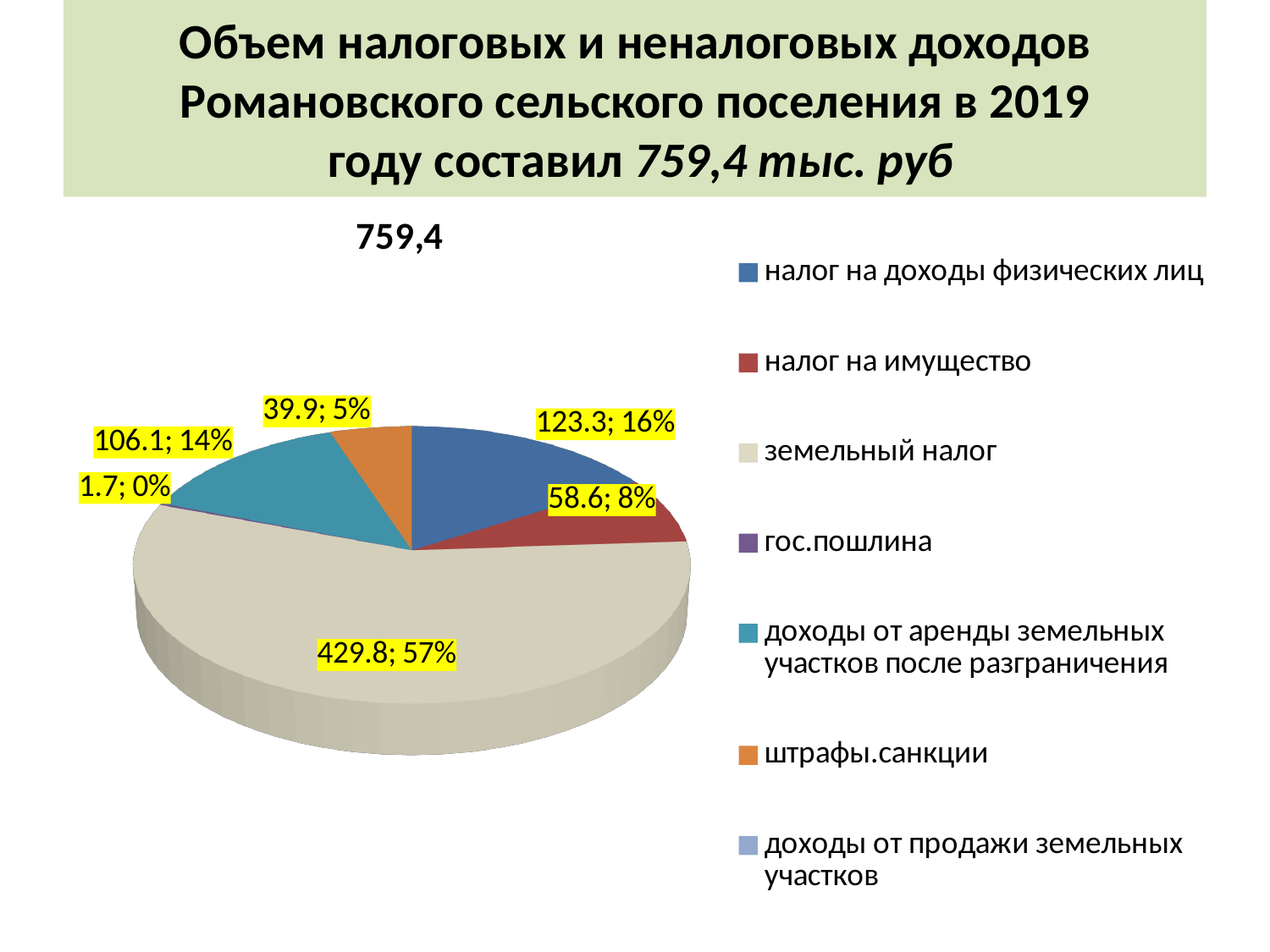
Which category has the largest slice of the pie? земельный налог What share of the pie does налог на имущество represent? 8% What kind of chart is shown on the slide? pie chart How many entries does the legend list? 7 What share of the pie does земельный налог represent? 57% Which labelled category has the smallest slice of the pie? гос.пошлина What is the value shown for штрафы.санкции? 39.9 What is the value shown for земельный налог? 429.8 Which is larger, налог на доходы физических лиц or налог на имущество? налог на доходы физических лиц What is the value shown for доходы от аренды земельных участков после разграничения? 106.1 What is the difference between the values for налог на доходы физических лиц and налог на имущество? 64.7 What is the value shown for налог на доходы физических лиц? 123.3